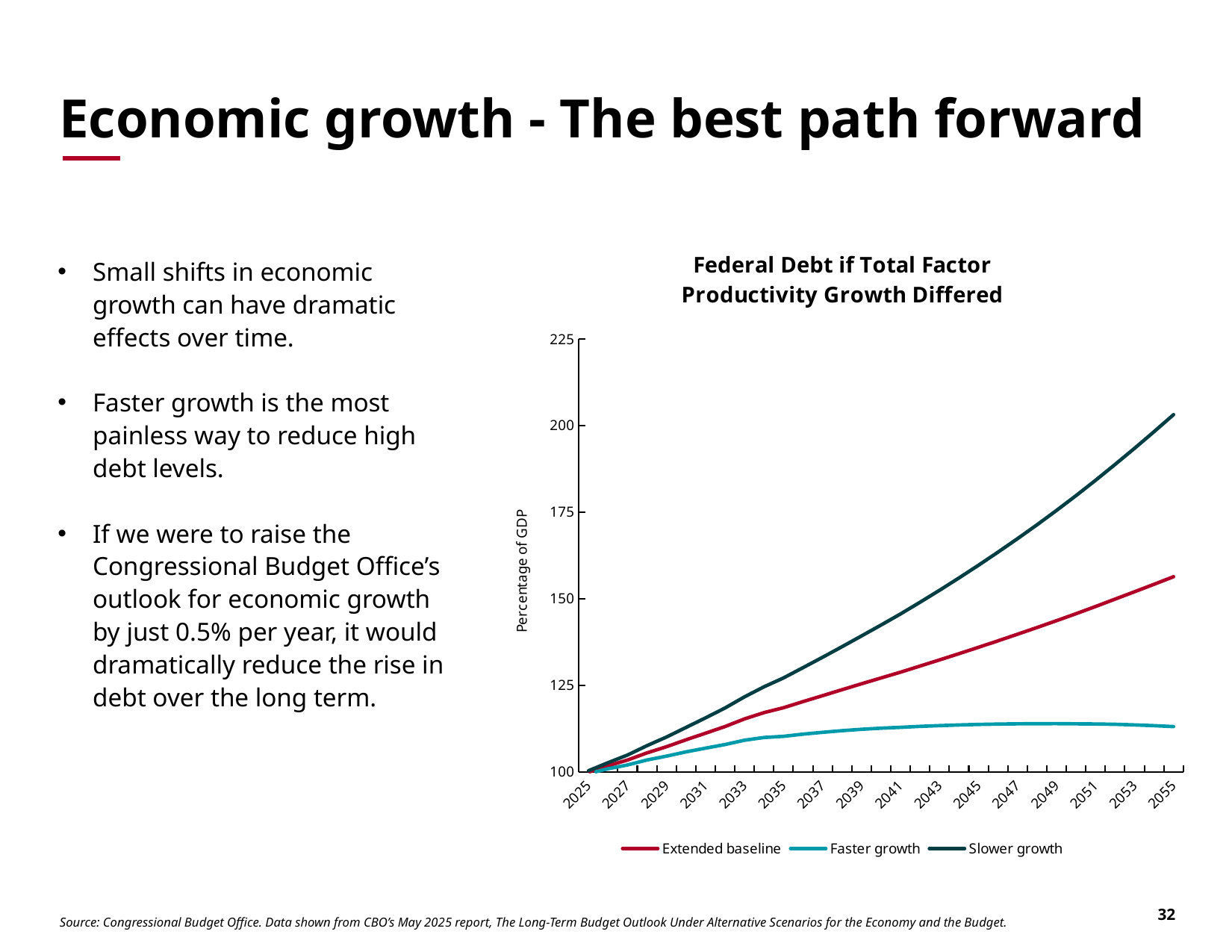
What is the label on the vertical axis of the chart? Percentage of GDP Which series has the highest value in 2055? Slower growth Is the value for Slower growth in 2055 greater or less than 200? greater How many series does the legend list? 3 In 2045, which is larger: the value for Extended baseline or the value for Slower growth? Slower growth What kind of chart is shown on the slide? Line chart Does the Slower growth line rise or fall from 2025 to 2055? Rises What is the title of the chart? Federal Debt if Total Factor Productivity Growth Differed Is the value for Faster growth in 2055 greater or less than 125? less Which series has the lowest value in 2055? Faster growth Is the value for Extended baseline in 2055 greater or less than 150? greater